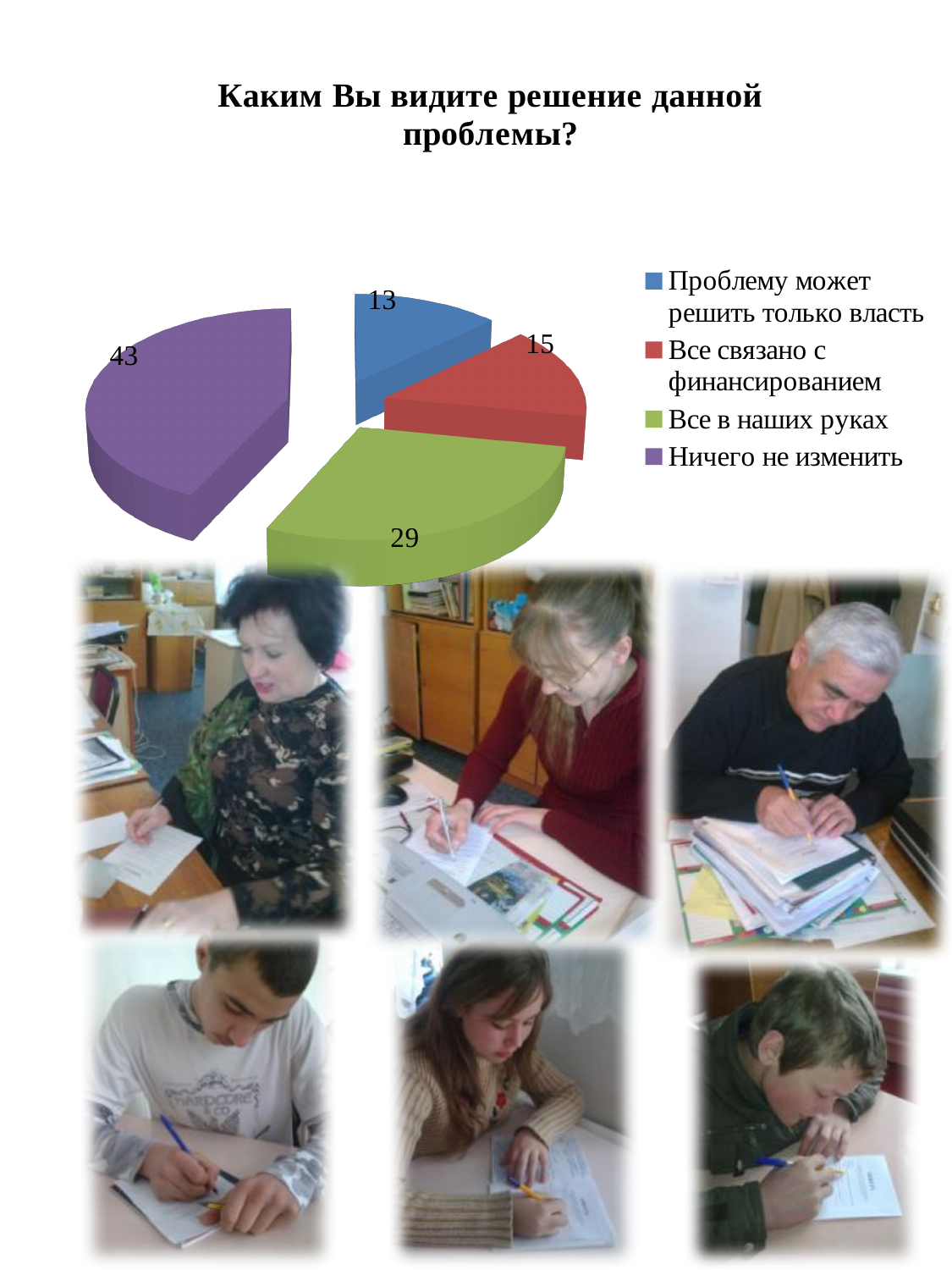
Which category has the smallest slice of the pie? Проблему может решить только власть What is the value for "Проблему может решить только власть"? 13 What colour is the slice for "Все в наших руках"? green What is the value for "Все связано с финансированием"? 15 What is the value for "Ничего не изменить"? 43 How many slices does the pie chart have? 4 Which is larger: the value for "Все связано с финансированием" or the value for "Проблему может решить только власть"? Все связано с финансированием What is the total of all the values shown on the pie chart? 100 Which category has the largest slice of the pie? Ничего не изменить What is the difference between the values for "Ничего не изменить" and "Все в наших руках"? 14 What type of chart is shown on the slide? pie chart What is the value for "Все в наших руках"? 29